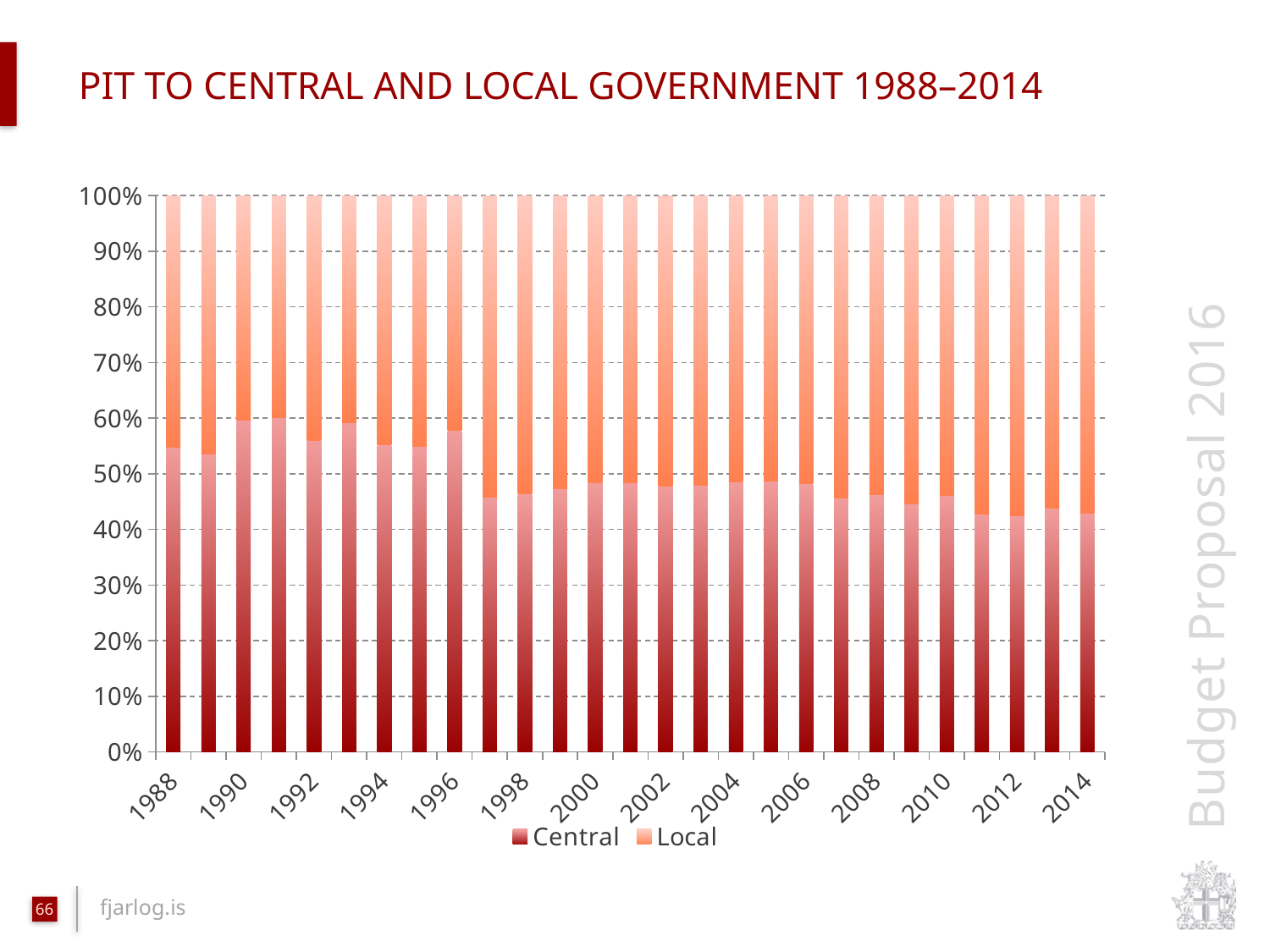
What is the total of each stacked bar? 100% In 2014, which series has the larger share, Central or Local? Local Is the Central share in 1988 greater or less than 50%? greater What kind of chart is shown on the slide? stacked bar chart Does the Central share rise or fall overall from 1988 to 2014? fall What are the two series named in the legend? Central and Local In 1988, which series has the larger share, Central or Local? Central Is the Central share in 1998 greater or less than 50%? less How many years (bars) are plotted in the chart? 27 Is the Central share in 2014 greater or less than 50%? less What is the title of the chart? PIT TO CENTRAL AND LOCAL GOVERNMENT 1988–2014 How many series does the legend list? 2